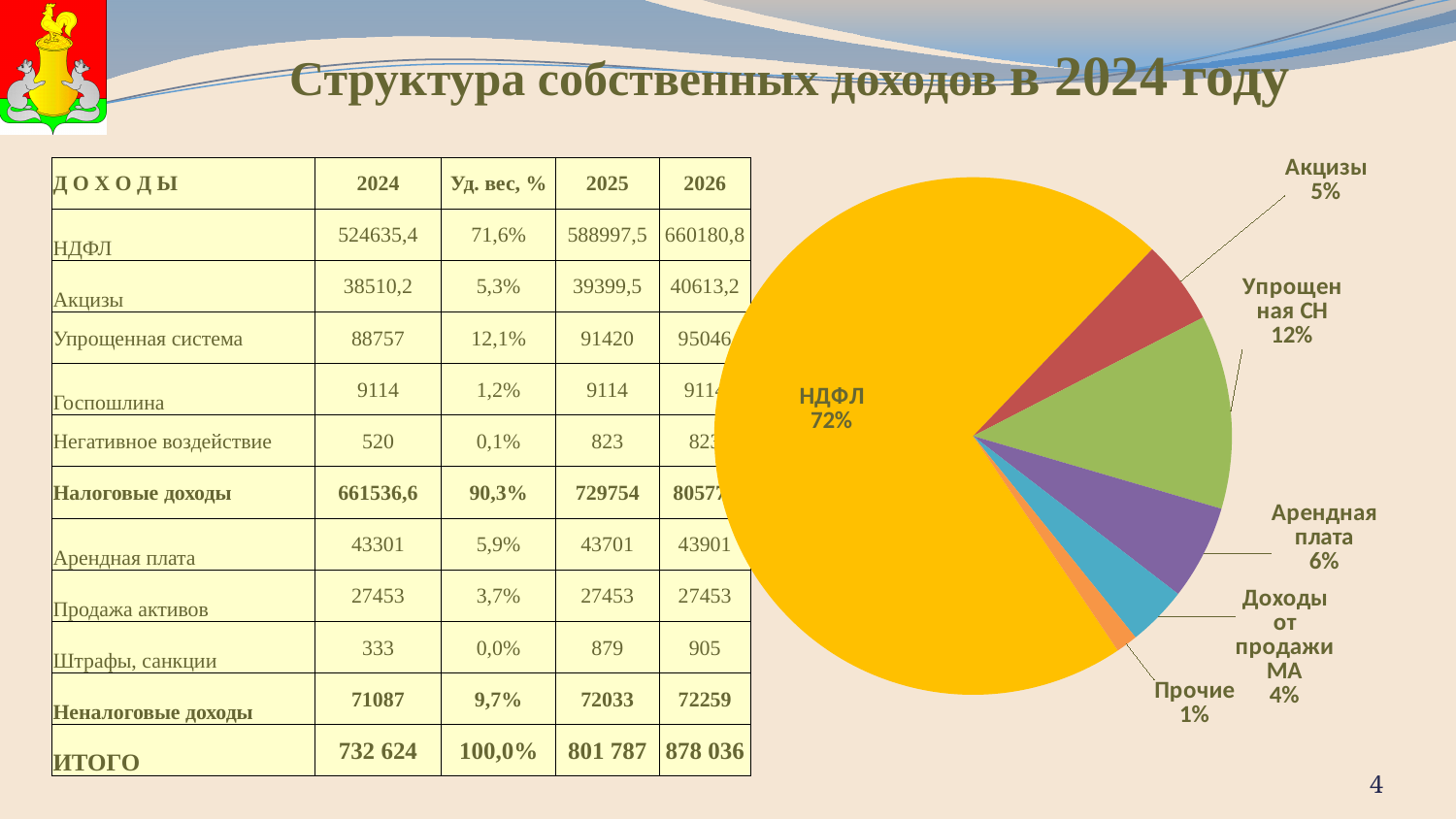
What share of the pie does Упрощенная СН have? 12% What is the difference in percentage points between the НДФЛ slice and the Упрощенная СН slice? 60 What share of the pie does Арендная плата have? 6% What share of the pie does Доходы от продажи МА have? 4% What share of the pie does Акцизы have? 5% Which slice of the pie chart is the largest? НДФЛ How many slices does the pie chart have? 6 What kind of chart is shown on the slide? pie chart What share of the pie does Прочие have? 1% What share of the pie does НДФЛ have? 72% Which slice is larger, Арендная плата or Акцизы? Арендная плата Which slice of the pie chart is the smallest? Прочие